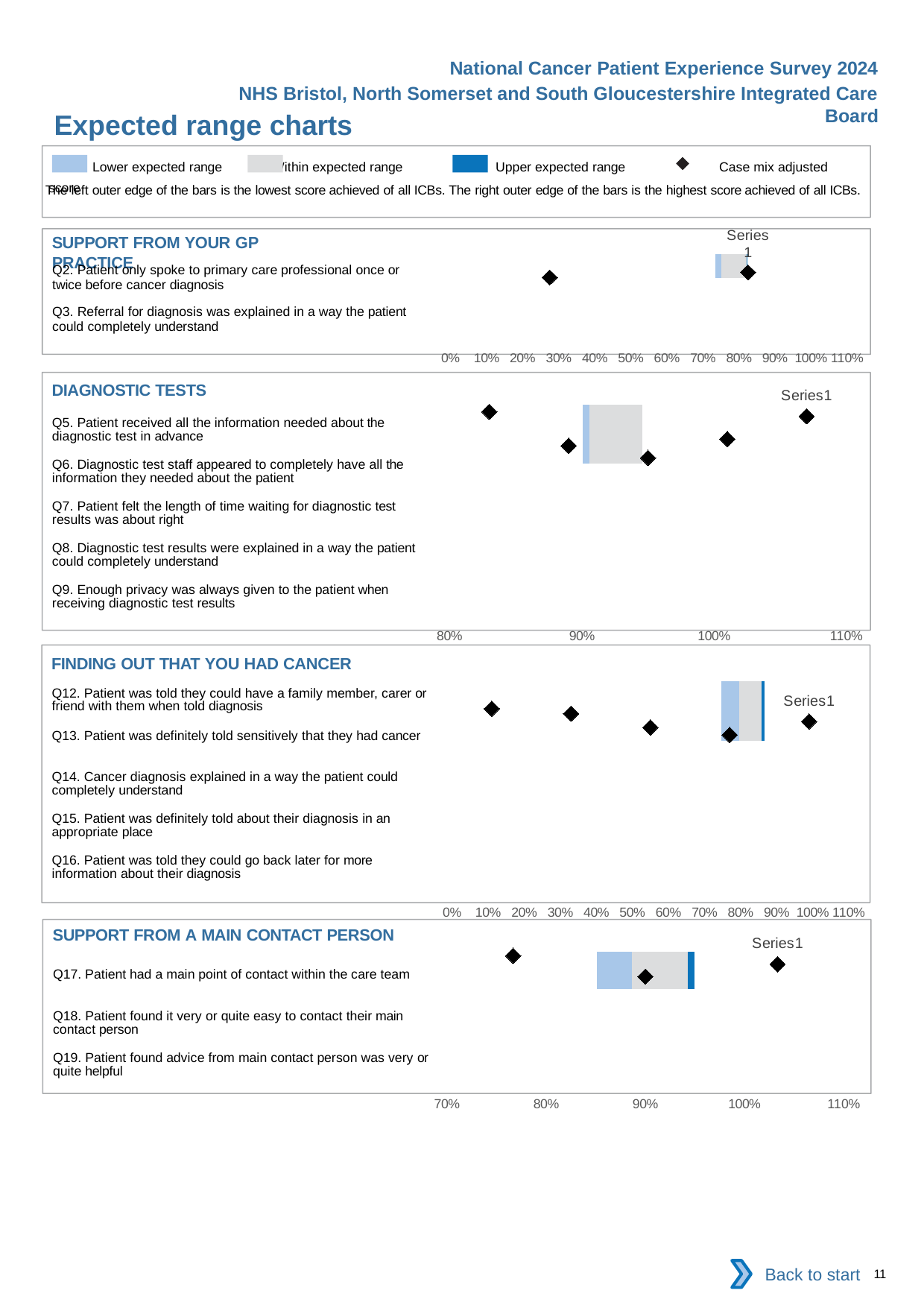
In the FINDING OUT THAT YOU HAD CANCER chart, how many diamond markers are plotted? 5 In the FINDING OUT THAT YOU HAD CANCER chart, is the rightmost diamond marker greater or less than 90%? greater In the DIAGNOSTIC TESTS chart, is the rightmost diamond marker greater or less than 100%? greater In the FINDING OUT THAT YOU HAD CANCER chart, is the leftmost diamond marker greater or less than 20%? less In the DIAGNOSTIC TESTS chart, what is the lowest value shown on the x axis? 80% How many questions (Q5 to Q9) are listed in the DIAGNOSTIC TESTS chart? 5 In the SUPPORT FROM A MAIN CONTACT PERSON chart, what is the lowest value shown on the x axis? 70% In the DIAGNOSTIC TESTS chart, how many diamond markers are plotted? 5